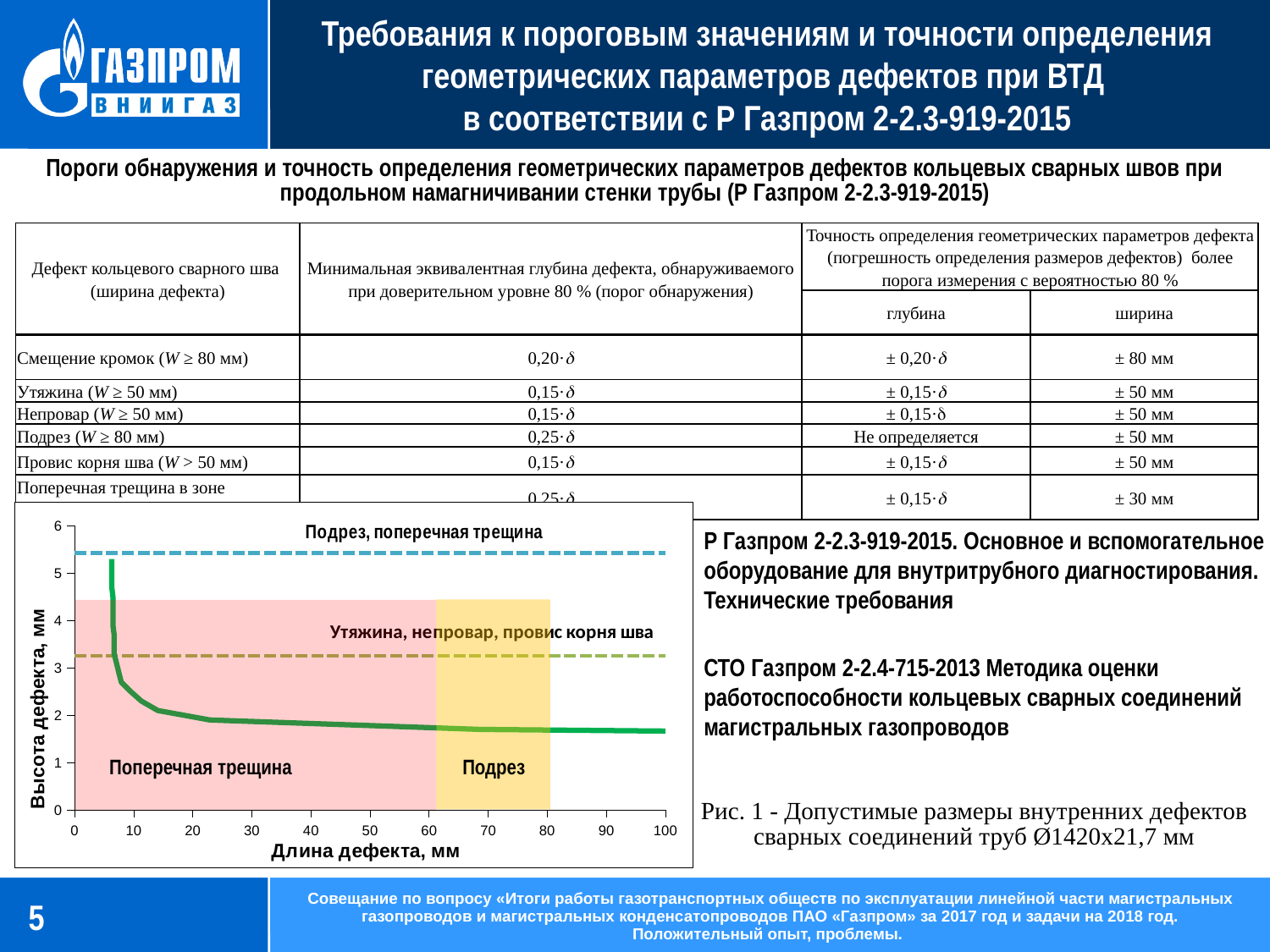
Is the value of the green curve at a defect length of 10 mm greater or less than 2? greater Is the value of the green curve at a defect length of 100 mm greater or less than 2? less What is the title of the y axis of the chart? Высота дефекта, мм What is the title of the x axis of the chart? Длина дефекта, мм What is the maximum value shown on the x axis of the chart? 100 Is the dashed line labelled 'Утяжина, непровар, провис корня шва' greater or less than 3 on the y axis? greater In the chart, does the green curve rise or fall as the defect length increases along the x axis? fall What kind of chart is shown at the bottom left of the slide? line chart How many dashed horizontal lines are drawn on the chart? 2